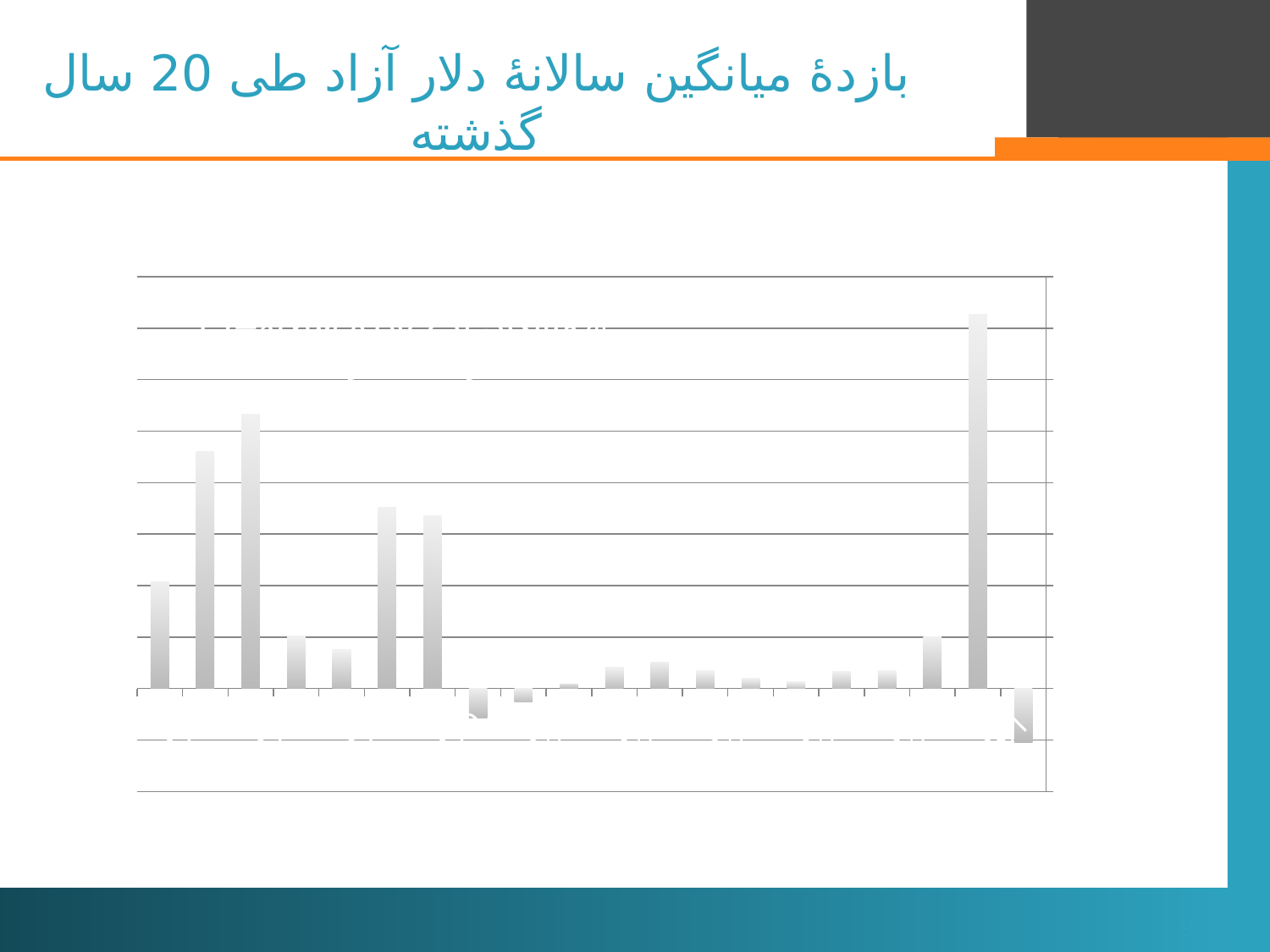
What kind of chart is shown on the slide? bar chart How many bars in the chart extend below the zero line? 3 How many bars are plotted in the chart? 20 Is the tallest bar in the chart located near the left end or near the right end of the x axis? near the right end Is the last bar on the right of the chart above or below the zero line? below